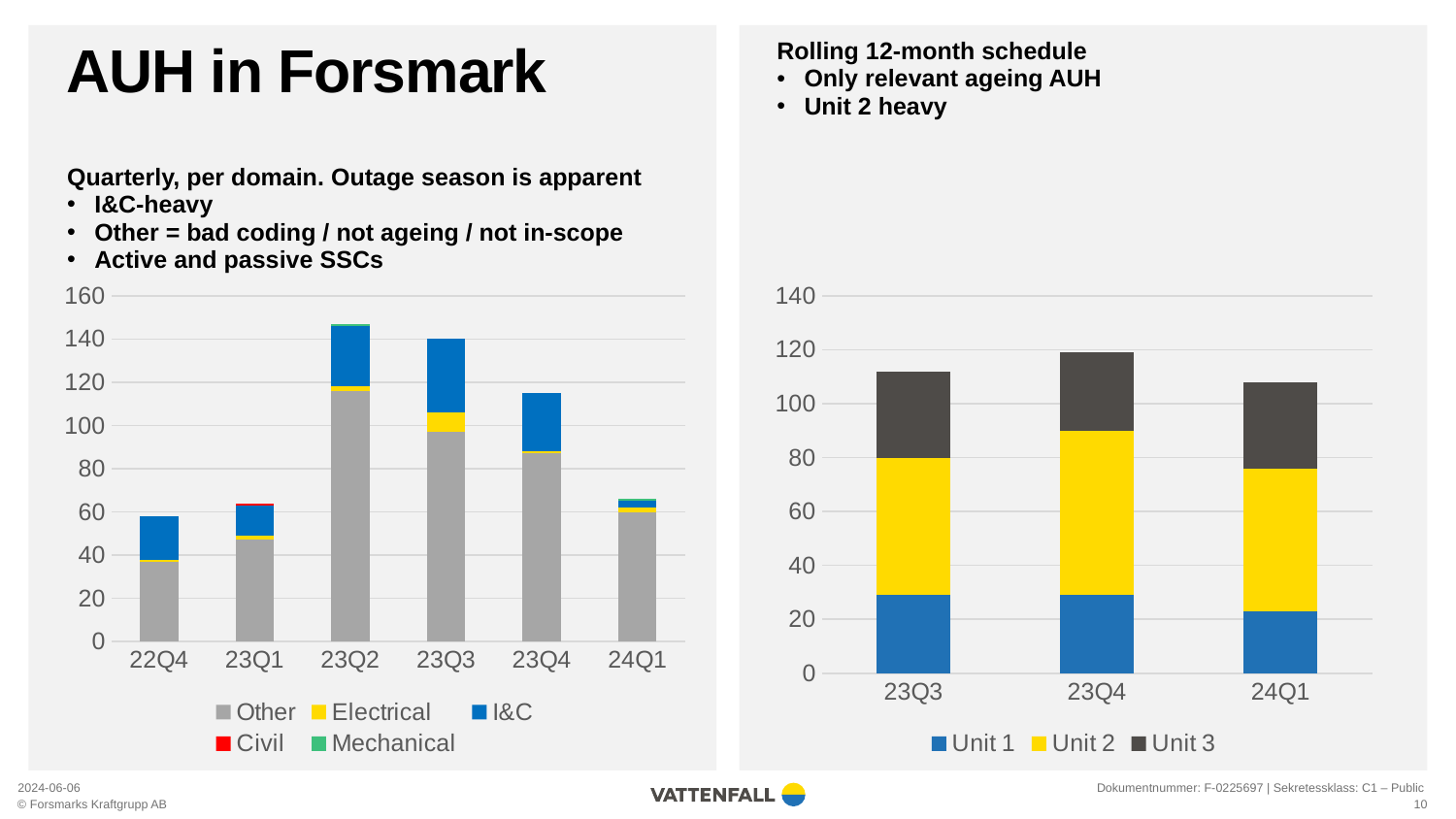
In the right chart (Rolling 12-month schedule), is the Unit 1 segment for 24Q1 greater or less than 40? less In the right chart (Rolling 12-month schedule), which quarter has the highest total bar? 23Q4 In the left chart (Quarterly, per domain), which total bar is larger, 23Q4 or 24Q1? 23Q4 In the left chart (Quarterly, per domain), is the total for 24Q1 greater or less than 100? less How many series does the legend of the left chart (Quarterly, per domain) list? 5 In the left chart (Quarterly, per domain), which quarter has the highest total bar? 23Q2 In the left chart (Quarterly, per domain), which quarter has the lowest total bar? 22Q4 In the left chart (Quarterly, per domain), is the total for 23Q2 greater or less than 140? greater How many quarters are shown on the x axis of the left chart (Quarterly, per domain)? 6 What kind of chart is the right chart (Rolling 12-month schedule)? Stacked bar chart In the left chart (Quarterly, per domain), do the total bars rise or fall from 23Q2 to 24Q1? fall How many series does the legend of the right chart (Rolling 12-month schedule) list? 3